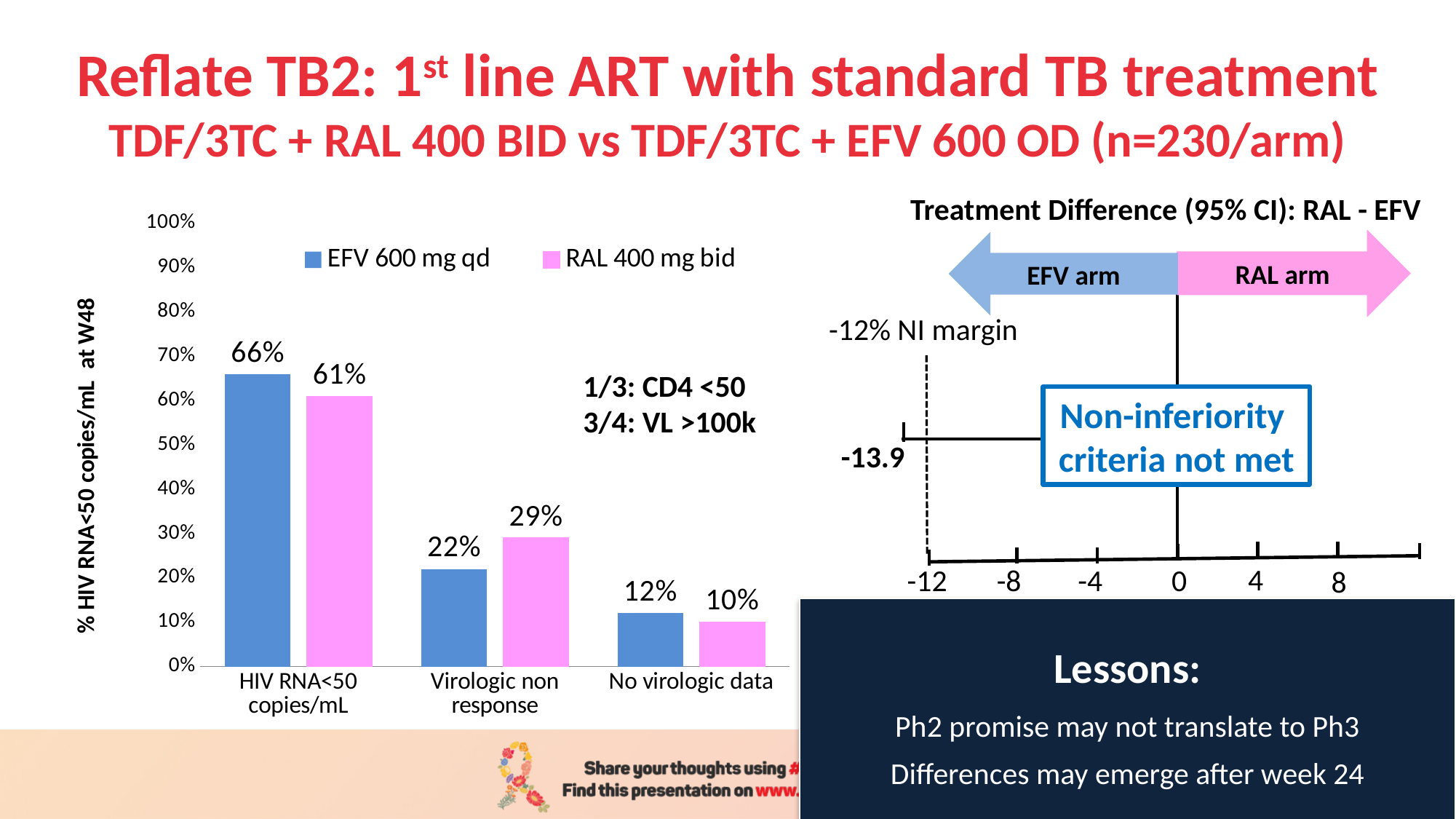
What kind of chart is shown on the left of the slide? Bar chart In the Treatment Difference (95% CI) chart on the right, what is the lower bound of the confidence interval labelled on the plot? -13.9 In the bar chart on the left, what is the value for RAL 400 mg bid in the HIV RNA<50 copies/mL category? 61% In the bar chart on the left, what is the value for EFV 600 mg qd in the No virologic data category? 12% In the bar chart on the left, what is the difference between the EFV 600 mg qd and RAL 400 mg bid values in the Virologic non response category? 7% In the bar chart on the left, which category has the highest value for EFV 600 mg qd? HIV RNA<50 copies/mL In the bar chart on the left, what is the value for RAL 400 mg bid in the Virologic non response category? 29% In the bar chart on the left, which series has the larger value in the HIV RNA<50 copies/mL category? EFV 600 mg qd In the bar chart on the left, which category has the lowest value for RAL 400 mg bid? No virologic data In the bar chart on the left, what is the value for EFV 600 mg qd in the HIV RNA<50 copies/mL category? 66% In the bar chart on the left, how many series does the legend list? 2 In the bar chart on the left, how many categories are shown on the x axis? 3